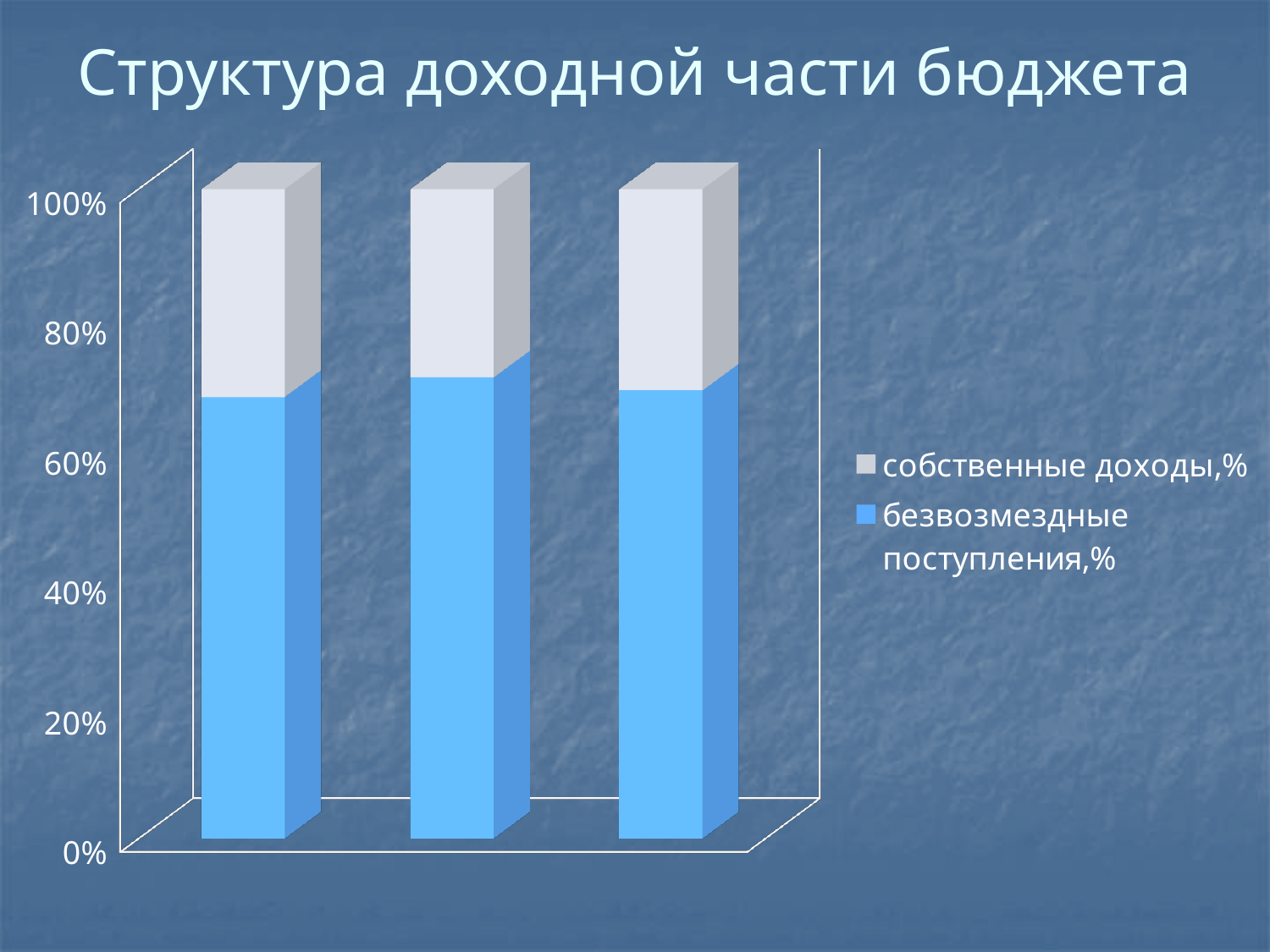
What is the total of each stacked bar? 100% Is the value of безвозмездные поступления,% in the middle bar greater or less than 80%? less What is the highest value shown on the vertical axis? 100% How many series does the legend list? 2 Is the value of безвозмездные поступления,% in the leftmost bar greater or less than 60%? greater Which series is shown in blue according to the legend? безвозмездные поступления,% What is the title of the chart? Структура доходной части бюджета What kind of chart is shown on the slide? stacked bar chart In the leftmost bar, which series has the larger share: собственные доходы,% or безвозмездные поступления,%? безвозмездные поступления,% Is the value of безвозмездные поступления,% in the rightmost bar greater or less than 60%? greater How many bars are plotted in the chart? 3